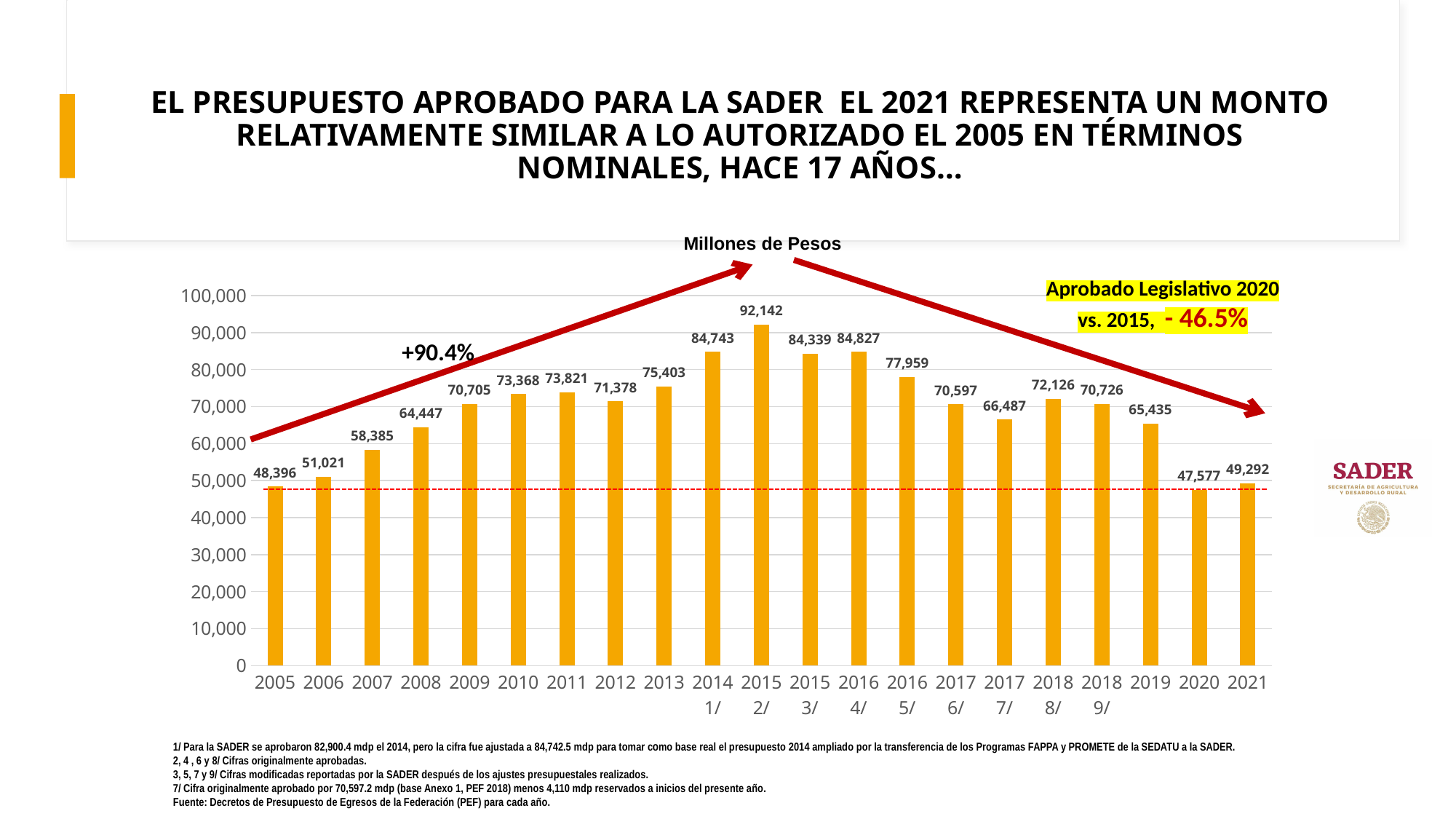
What is the value for 2019? 65,435 How many bars are shown in the chart? 21 Which year has the lowest value? 2020 Which year has the highest value? 2015 2/ What is the value for 2021? 49,292 Is the value for 2013 greater or less than 70,000? greater What is the difference between the values for 2021 and 2020? 1,715 What kind of chart is shown on the slide? bar chart Which is larger, the value for 2007 or the value for 2008? 2008 What unit label is shown above the chart? Millones de Pesos What is the value for 2005? 48,396 What is the difference between the values for 2015 2/ and 2005? 43,746